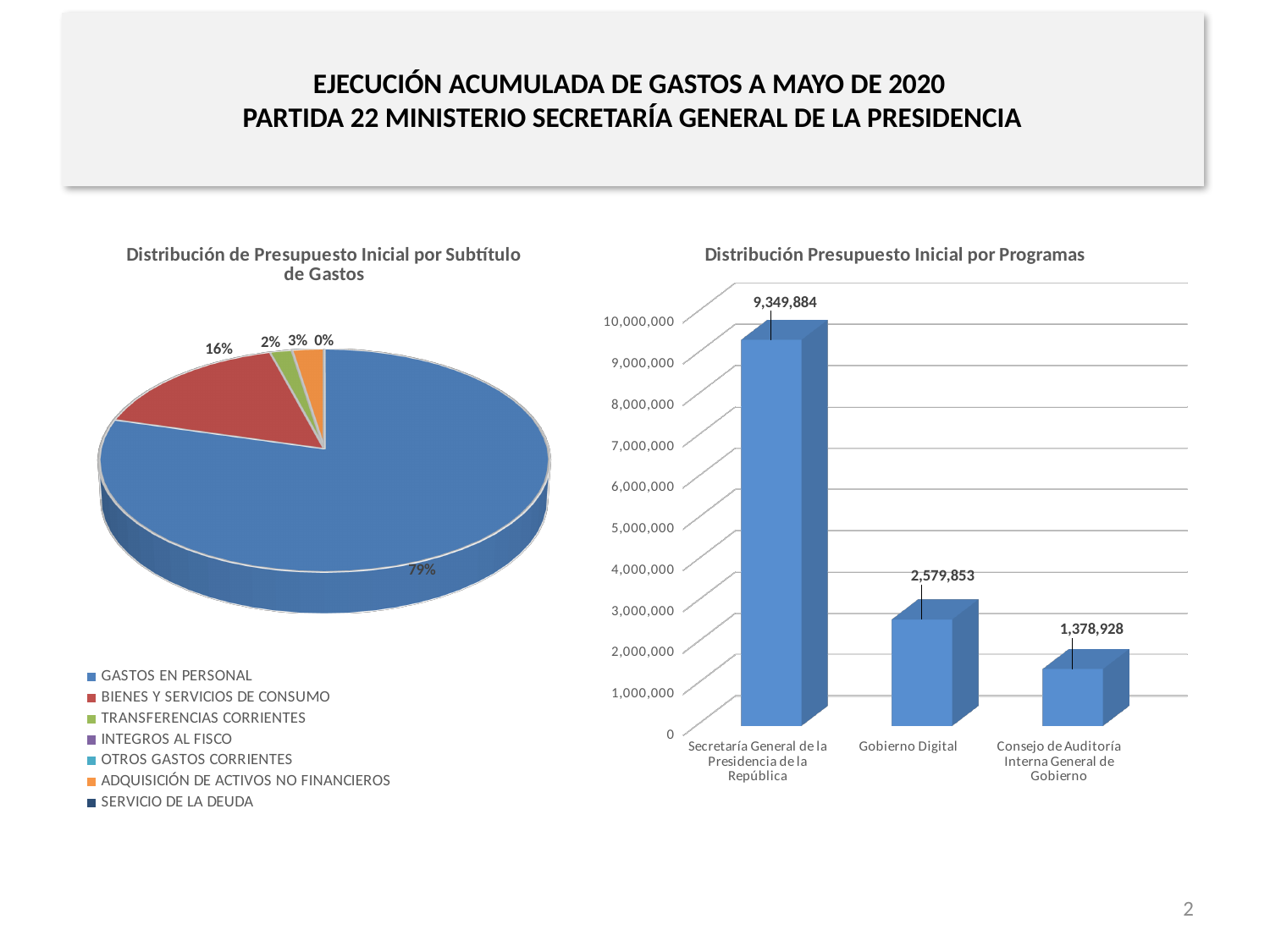
In the chart 'Distribución Presupuesto Inicial por Programas', how many programs are shown? 3 What kind of chart is 'Distribución de Presupuesto Inicial por Subtítulo de Gastos'? Pie chart In the chart 'Distribución Presupuesto Inicial por Programas', what is the difference between the values for Gobierno Digital and Consejo de Auditoría Interna General de Gobierno? 1,200,925 In the pie chart 'Distribución de Presupuesto Inicial por Subtítulo de Gastos', what share does GASTOS EN PERSONAL have? 79% In the chart 'Distribución Presupuesto Inicial por Programas', what is the value for Gobierno Digital? 2,579,853 In the pie chart 'Distribución de Presupuesto Inicial por Subtítulo de Gastos', what share does BIENES Y SERVICIOS DE CONSUMO have? 16% What kind of chart is 'Distribución Presupuesto Inicial por Programas'? Bar chart In the chart 'Distribución Presupuesto Inicial por Programas', what is the value for Consejo de Auditoría Interna General de Gobierno? 1,378,928 In the pie chart 'Distribución de Presupuesto Inicial por Subtítulo de Gastos', how many entries does the legend list? 7 In the chart 'Distribución Presupuesto Inicial por Programas', which program has the highest value? Secretaría General de la Presidencia de la República In the chart 'Distribución Presupuesto Inicial por Programas', what is the value for Secretaría General de la Presidencia de la República? 9,349,884 In the chart 'Distribución Presupuesto Inicial por Programas', which program has the lowest value? Consejo de Auditoría Interna General de Gobierno